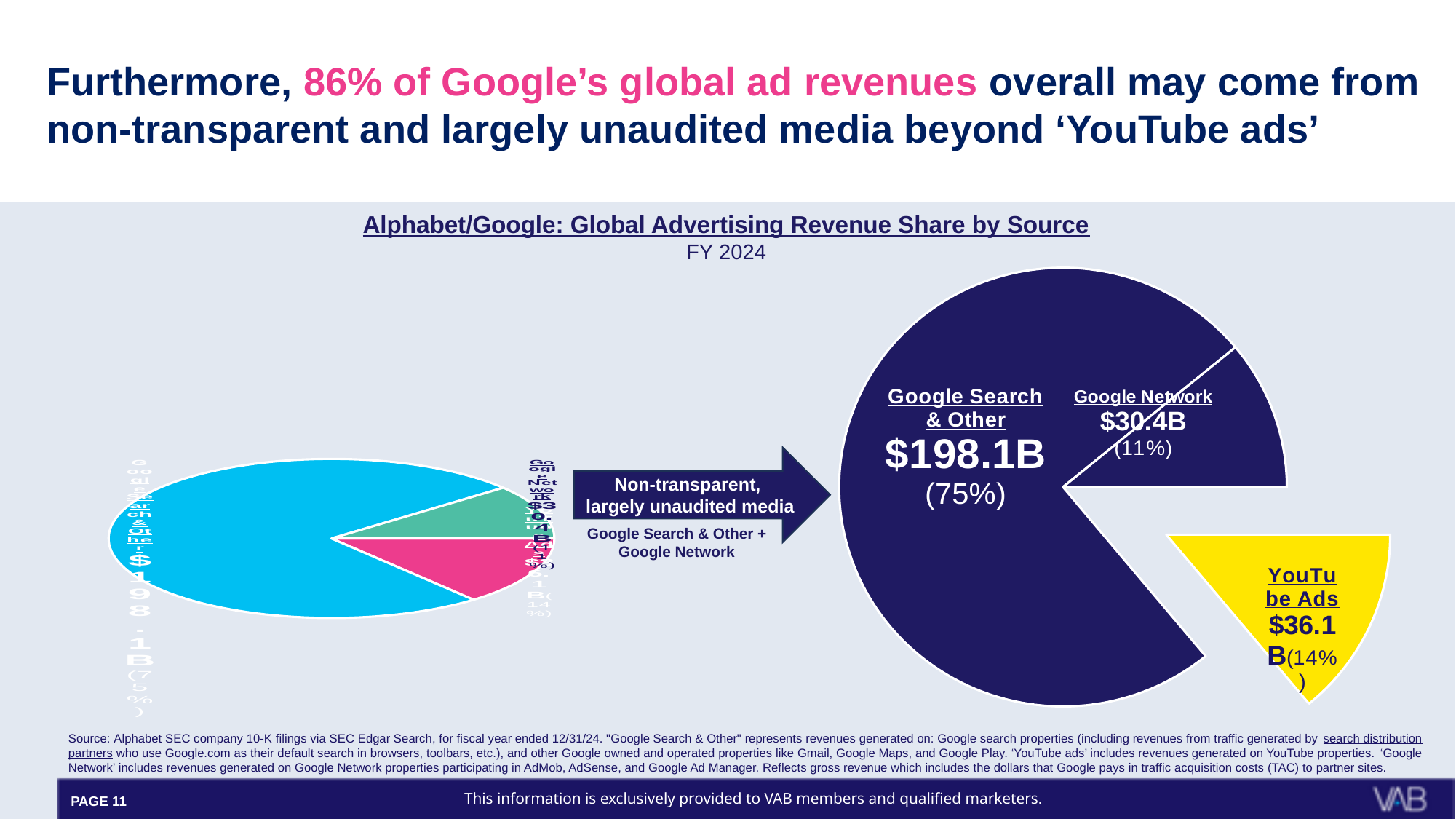
In the pie chart on the right, what is the value for Google Network? $30.4B In the pie chart on the right, what share of the pie does YouTube Ads represent? 14% In the pie chart on the right, which source has the smallest slice? Google Network What kind of chart is the large chart on the right of the slide? pie chart In the pie chart on the right, what share of the pie does Google Search & Other represent? 75% In the pie chart on the right, which is larger, YouTube Ads or Google Network? YouTube Ads In the pie chart on the right, what is the value for YouTube Ads? $36.1B In the pie chart on the right, what is the difference between YouTube Ads and Google Network? $5.7B In the pie chart on the right, what share of the pie does Google Network represent? 11% In the pie chart on the right, which source is shown in yellow? YouTube Ads In the pie chart on the right, what is the value for Google Search & Other? $198.1B In the pie chart on the right, which source has the largest slice? Google Search & Other